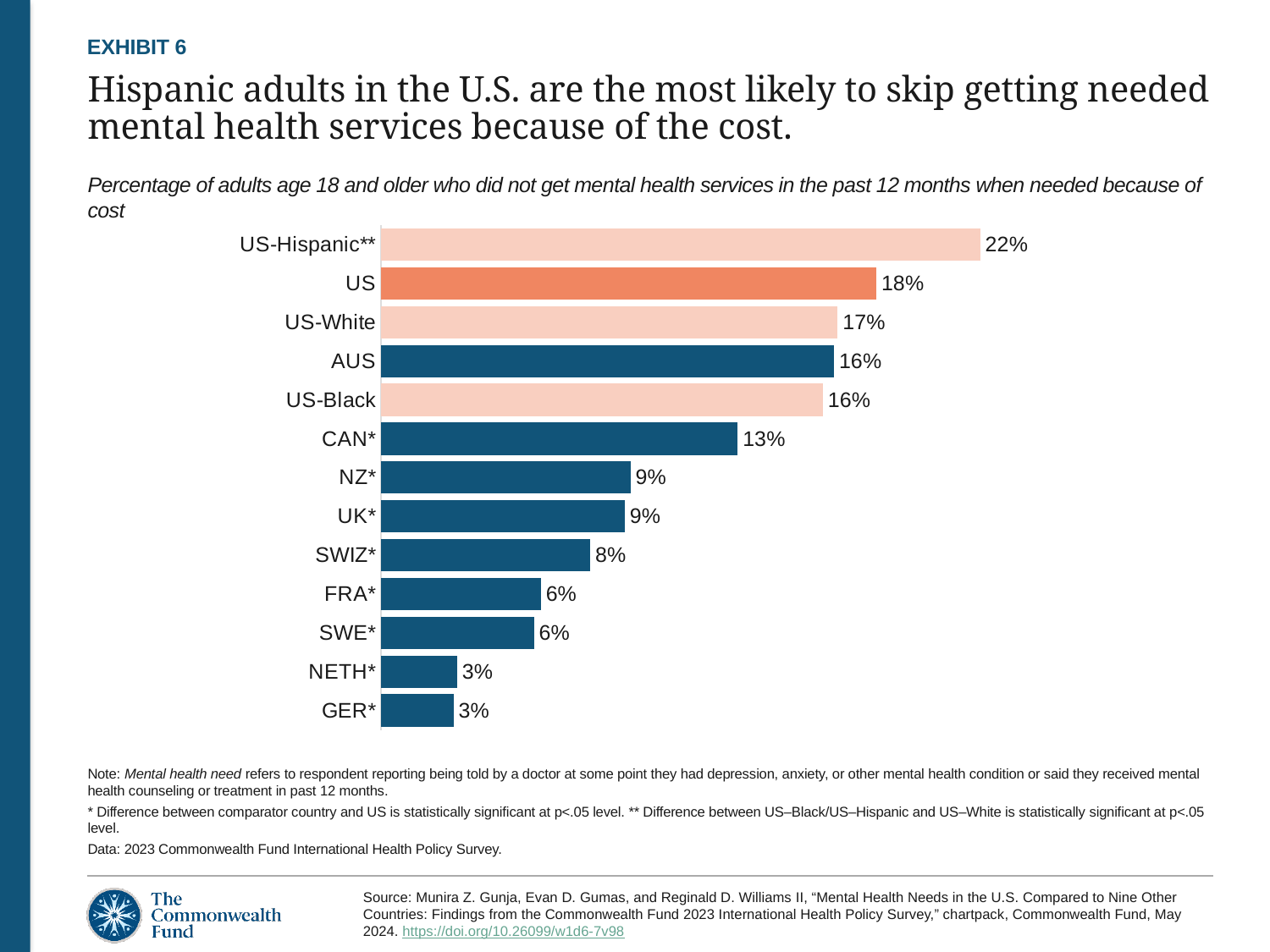
What is the difference between the values for US and US-White? 1% Do the values rise or fall going from the top bar to the bottom bar? Fall Which category has the highest value? US-Hispanic** What kind of chart is shown on the slide? Bar chart Which is larger, the value for FRA* or the value for NZ*? NZ* What is the value for SWIZ*? 8% What is the difference between the values for US-Hispanic** and GER*? 19% What is the value for US-Hispanic**? 22% How many categories are shown in the chart? 13 What is the value for CAN*? 13% Which is larger, the value for AUS or the value for CAN*? AUS Which bar is shown in a darker orange colour than the other US bars? US